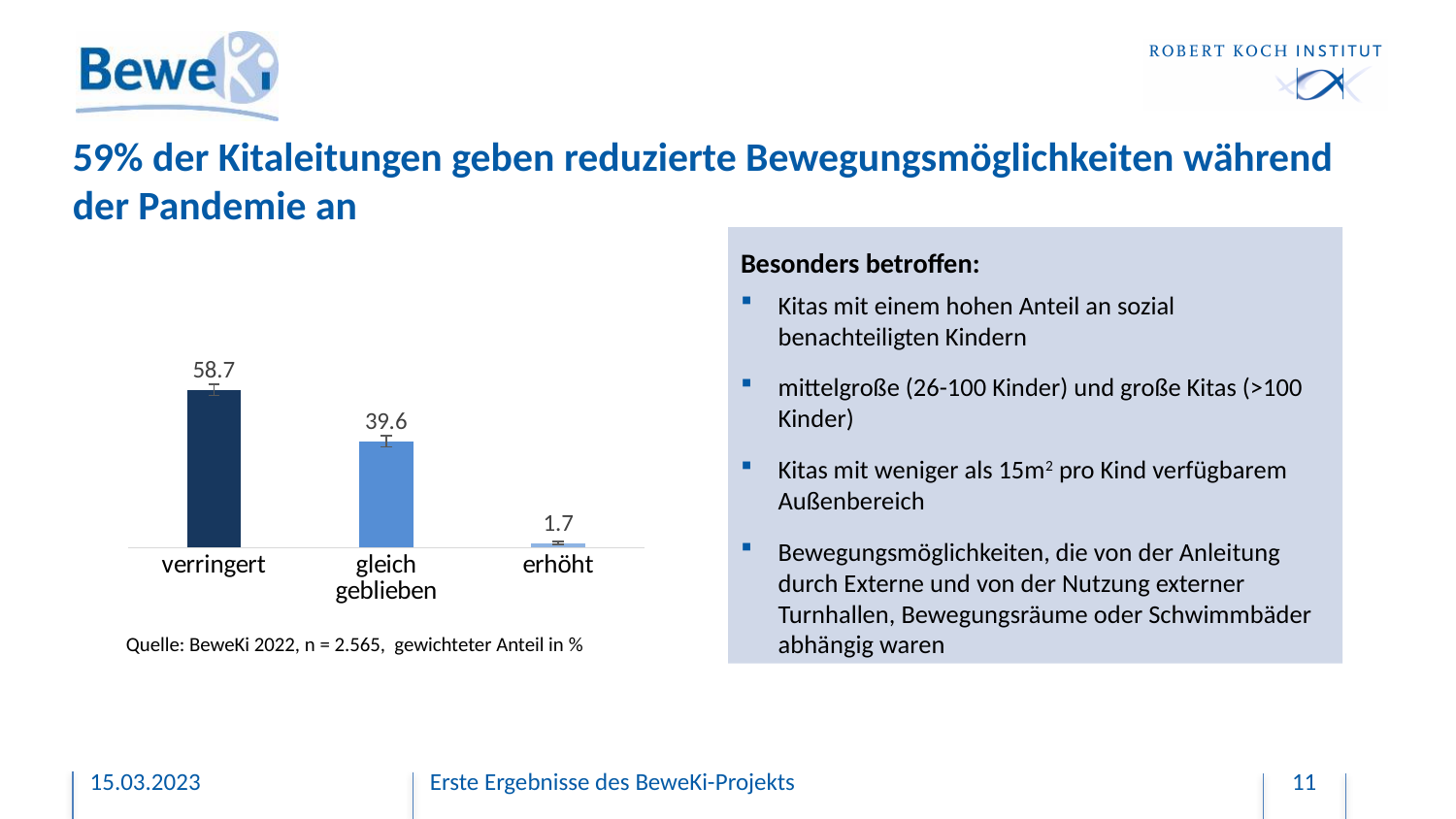
According to the source note below the chart, what is the sample size n? 2.565 What is the value for "erhöht"? 1.7 How many categories are shown in the chart? 3 Do the values rise or fall from left to right along the x axis? fall Which is larger, the value for "gleich geblieben" or the value for "erhöht"? gleich geblieben What is the difference between the values for "gleich geblieben" and "erhöht"? 37.9 What is the value for "gleich geblieben"? 39.6 What is the value for "verringert"? 58.7 What is the difference between the values for "verringert" and "gleich geblieben"? 19.1 Which category has the lowest value? erhöht Which category has the highest value? verringert What kind of chart is shown on the slide? bar chart